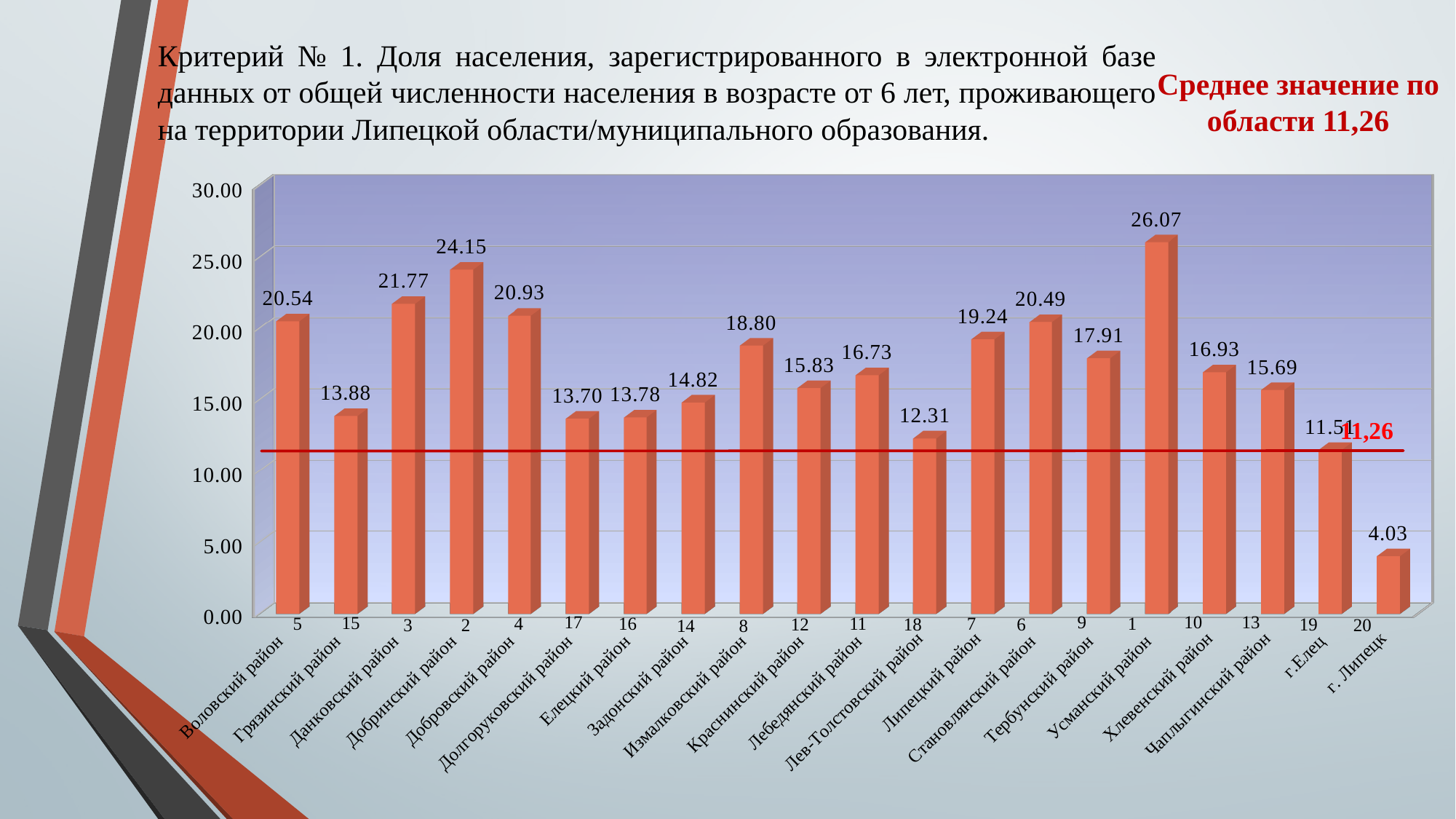
Is the value for Лев-Толстовский район greater or less than 15.00? less What is the difference between the values for Усманский район and г. Липецк? 22.04 Which category has the highest value? Усманский район What is the value for Усманский район? 26.07 How many categories are shown on the x axis? 20 What kind of chart is shown on the slide? bar chart Which is larger, the value for Воловский район or the value for Добровский район? Добровский район What is the difference between the values for Добринский район and Данковский район? 2.38 Which category has the lowest value? г. Липецк What value does the red horizontal line across the chart represent? 11,26 What is the value for Грязинский район? 13.88 What is the value for г. Липецк? 4.03